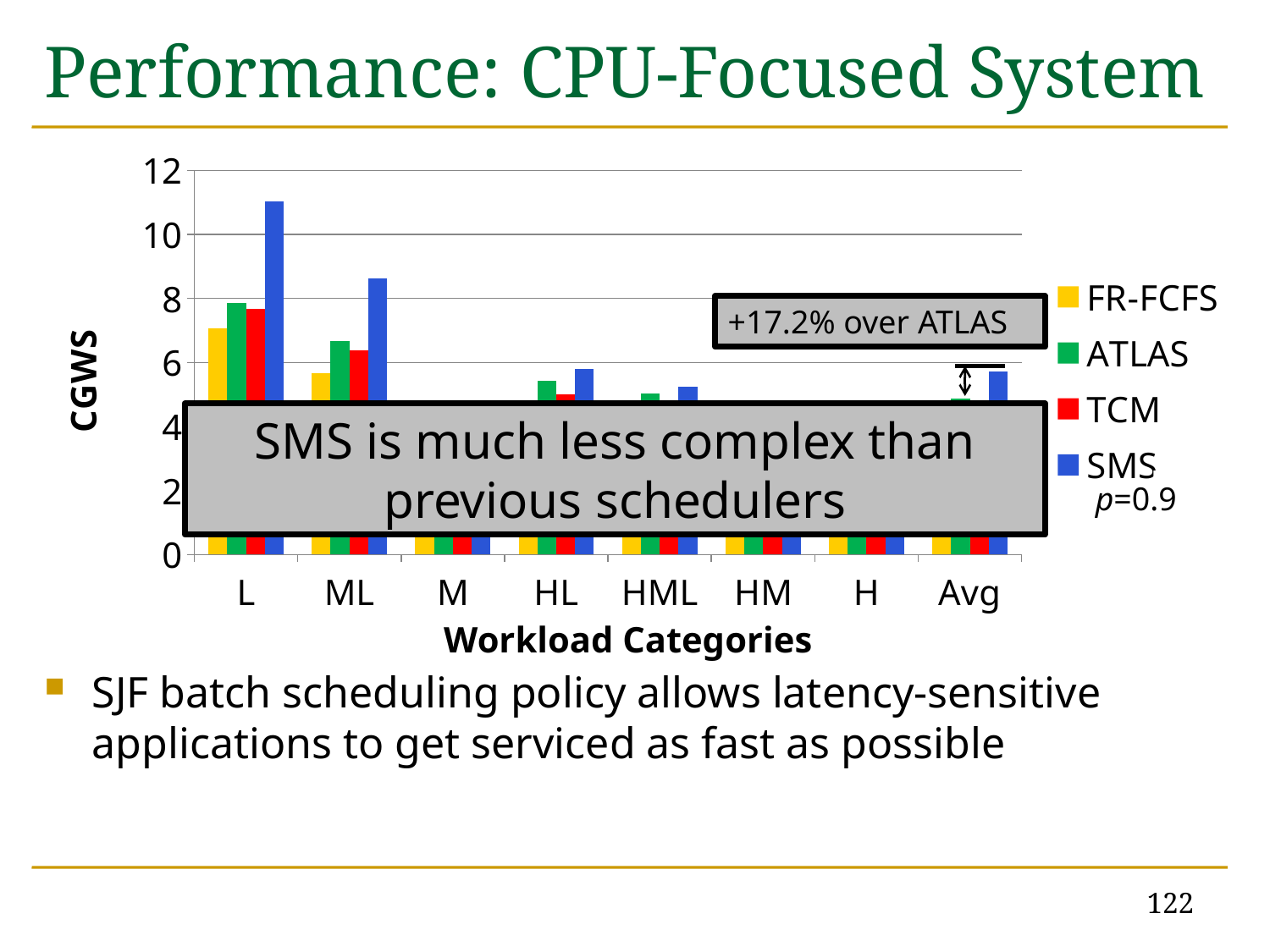
Is the SMS value for workload category ML greater or less than 8? greater How many series does the legend list? 4 Which scheduler has the highest CGWS for workload category L? SMS Is the FR-FCFS value for workload category L greater or less than 6? greater What kind of chart is shown on the slide? bar chart How many workload categories are shown on the x axis? 8 What improvement over ATLAS does the annotation on the chart state? +17.2% over ATLAS What is the title of the y axis? CGWS Is the SMS value for workload category L greater or less than 10? greater Which scheduler has the highest CGWS for workload category ML? SMS For workload category L, which is larger: the SMS value or the TCM value? SMS